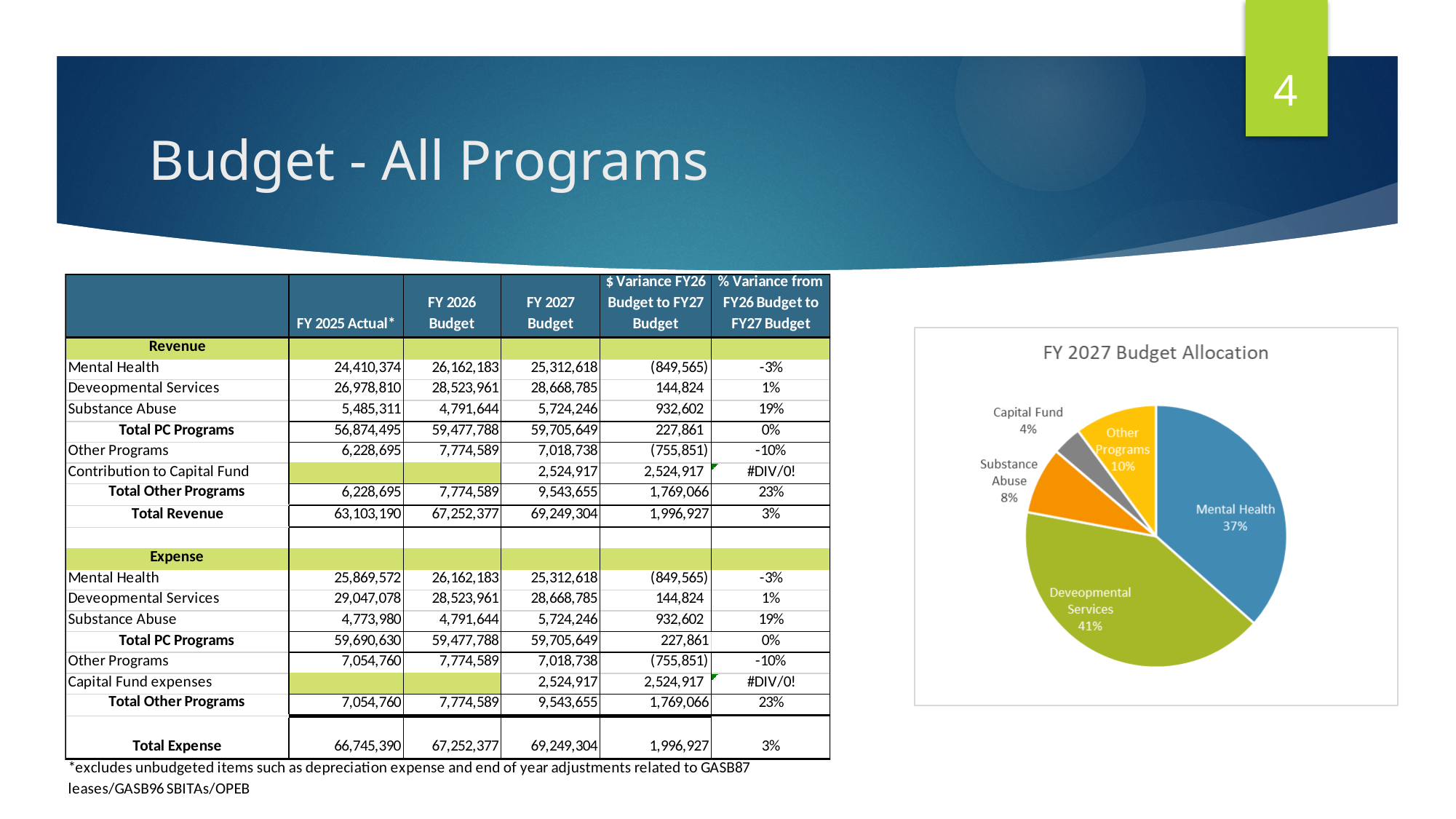
What percentage of the pie is Capital Fund? 4% What percentage of the pie is Substance Abuse? 8% What percentage of the pie is Other Programs? 10% What share of the FY 2027 budget allocation goes to Mental Health? 37% What type of chart is shown on the slide? pie chart Which slice of the pie chart is the smallest? Capital Fund Which slice of the pie chart is the largest? Deveopmental Services What colour is the Mental Health slice in the pie chart? blue What is the difference in percentage points between the Deveopmental Services slice and the Mental Health slice? 4 Which is larger, the Other Programs slice or the Substance Abuse slice? Other Programs How many slices does the pie chart have? 5 What is the title of the chart? FY 2027 Budget Allocation